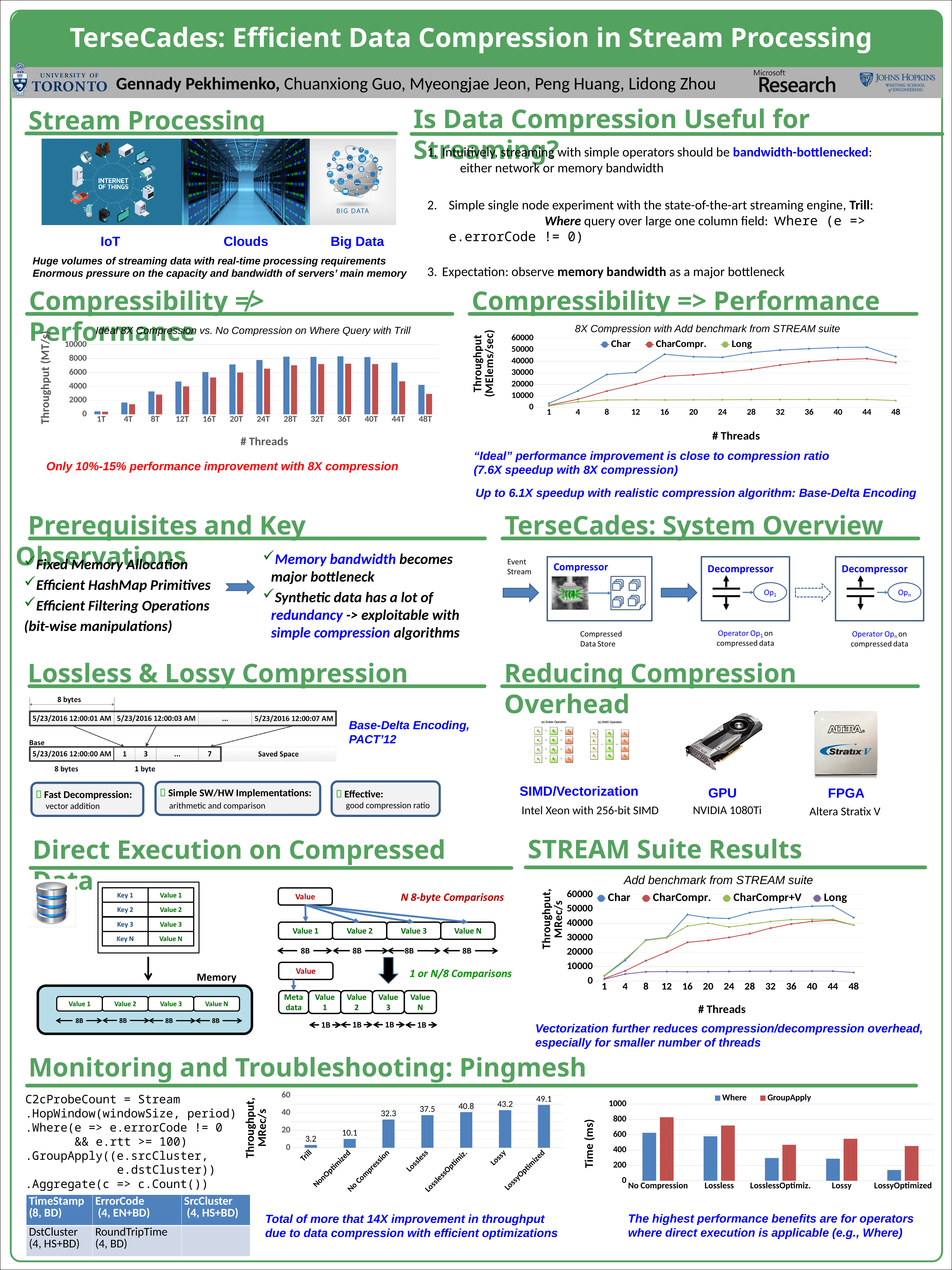
In the Pingmesh throughput bar chart (bottom middle), what is the throughput for LossyOptimized? 49.1 In the Pingmesh throughput bar chart (bottom middle), which category has the lowest throughput? Trill In the Pingmesh Time (ms) chart (bottom right), is the Where value for LossyOptimized greater or less than 200? less In the 'Add benchmark from STREAM suite' chart under STREAM Suite Results, how many series does the legend list? 4 In the 'Ideal 8X Compression vs. No Compression on Where Query with Trill' chart, how many thread-count categories are on the x axis? 13 In the Pingmesh throughput bar chart (bottom middle), how many categories are shown on the x axis? 7 In the Pingmesh throughput bar chart (bottom middle), what is the throughput for No Compression? 32.3 In the Pingmesh Time (ms) chart (bottom right), how many series does the legend list? 2 In the Pingmesh Time (ms) chart (bottom right), for No Compression, which is larger: Where or GroupApply? GroupApply What kind of chart is the 'Ideal 8X Compression vs. No Compression on Where Query with Trill' chart? bar chart In the Pingmesh throughput bar chart (bottom middle), what is the difference in throughput between LossyOptimized and Trill? 45.9 In the '8X Compression with Add benchmark from STREAM suite' chart, is the Char value at 16 threads greater or less than 40000? greater